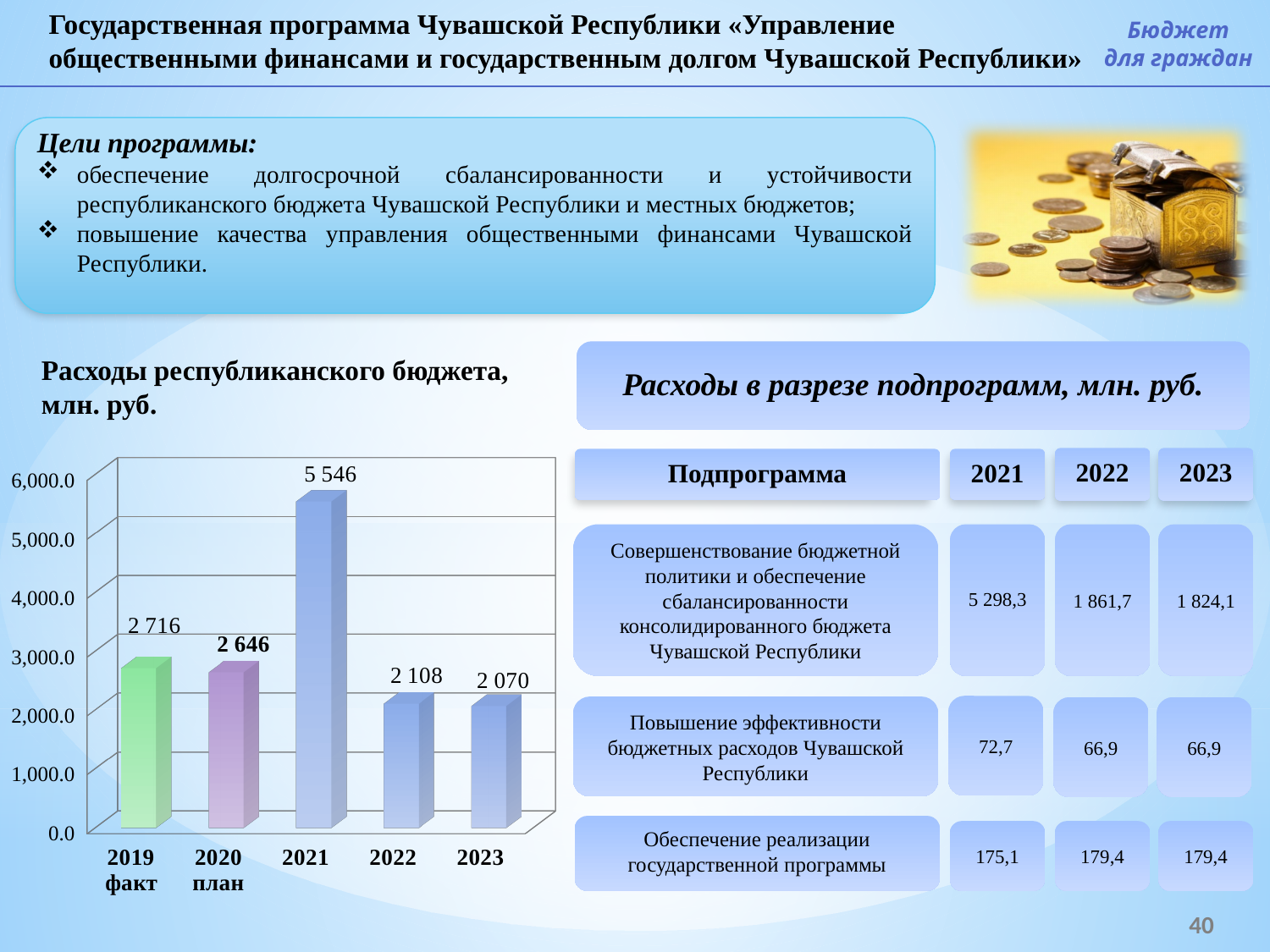
What is the difference between the values for 2021 and 2019 факт? 2 830 What is the value for 2021 in the chart 'Расходы республиканского бюджета, млн. руб.'? 5 546 What is the difference between the values for 2022 and 2023? 38 Which year has the highest value in the chart? 2021 Is the value for 2021 greater or less than 5,000.0? greater What is the value for 2023 in the chart? 2 070 How many years (categories) are shown in the chart? 5 Which year has the lowest value in the chart? 2023 What is the value for 2019 факт in the chart? 2 716 Which is larger, the value for 2019 факт or the value for 2020 план? 2019 факт What kind of chart is used to show the republican budget expenditures? bar chart Do the values rise or fall from 2021 to 2023? fall